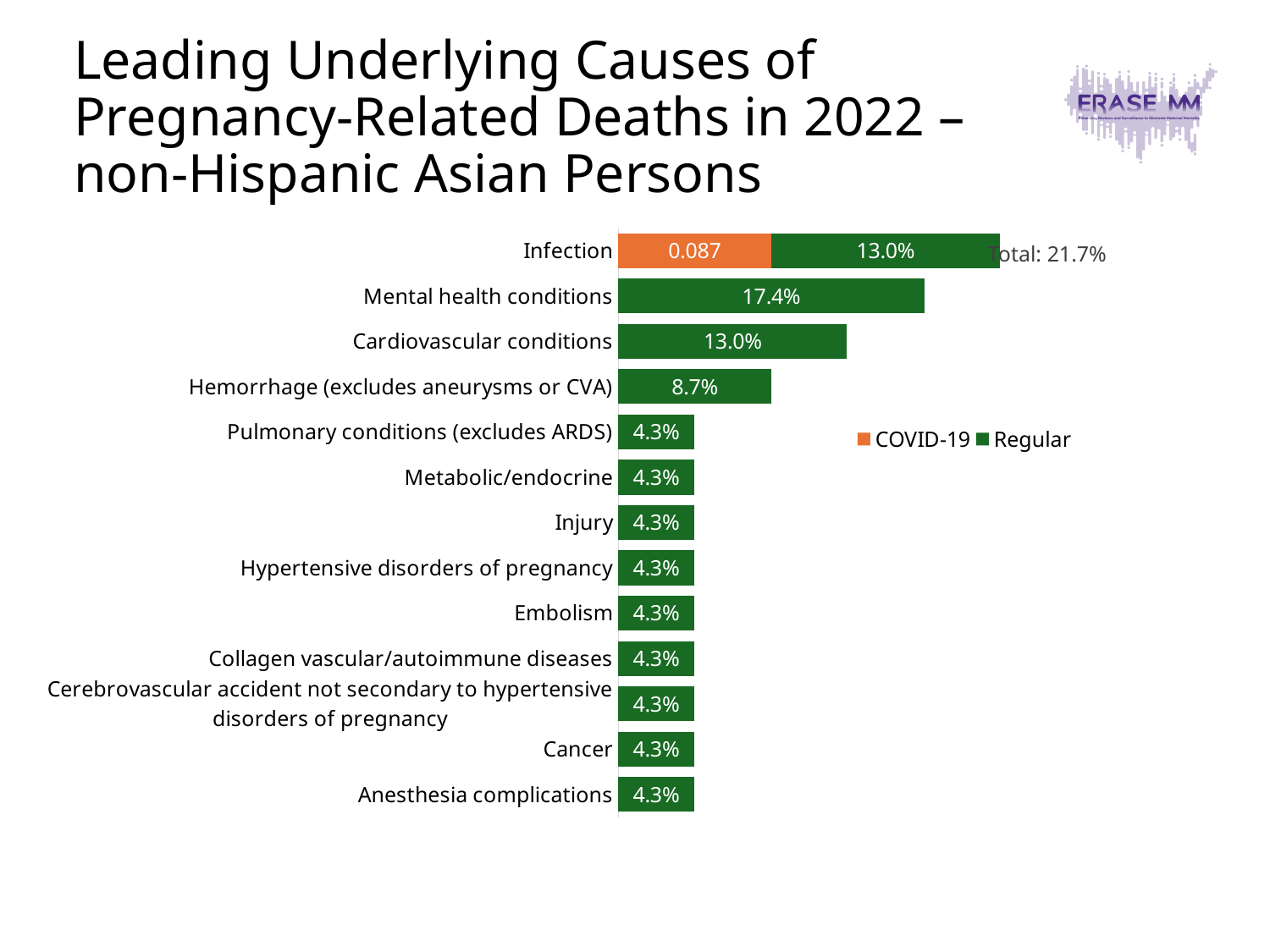
Which is larger, the Regular value for Cardiovascular conditions or for Hemorrhage (excludes aneurysms or CVA)? Cardiovascular conditions How many series does the legend list? 2 Which category has the highest total value? Infection What is the Regular value for Infection? 13.0% How many categories are shown in the chart? 13 What is the Regular value for Hemorrhage (excludes aneurysms or CVA)? 8.7% What is the COVID-19 value shown for Infection? 0.087 What kind of chart is shown on the slide? Stacked bar chart What is the Regular value for Mental health conditions? 17.4% What is the value for Cancer? 4.3% What is the difference between the Regular values for Mental health conditions and Cardiovascular conditions? 4.4% What total is labelled for the Infection bar? Total: 21.7%